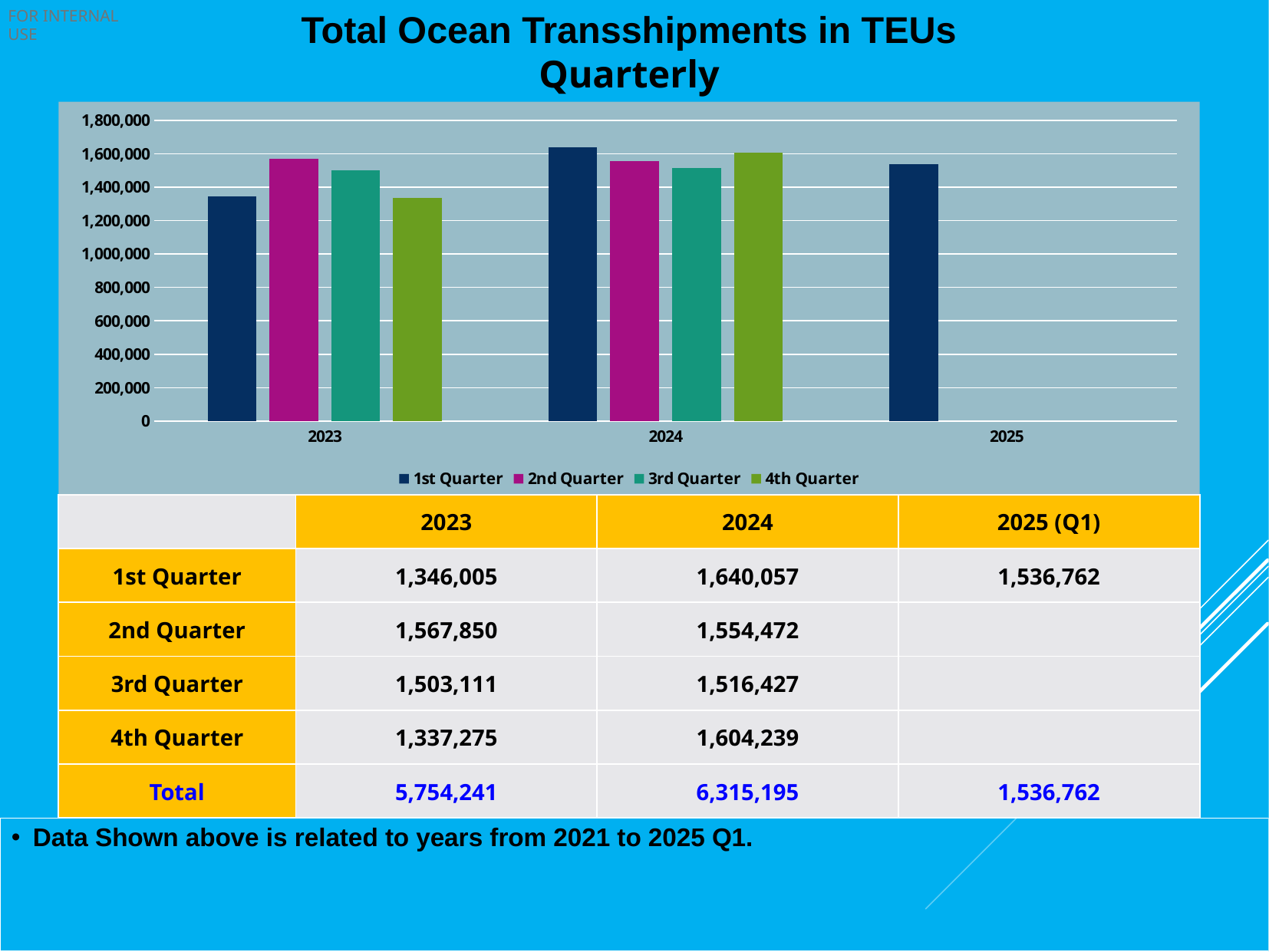
Which year and quarter has the lowest value in the chart? 2023, 4th Quarter Which is larger in 2023, the 2nd Quarter or the 3rd Quarter? 2nd Quarter What kind of chart is shown on the slide? bar chart Does the 1st Quarter value rise or fall from 2023 to 2024? rise How many year categories are shown on the x axis of the chart? 3 What is the value for the 1st Quarter in 2024? 1,640,057 What is the value for the 4th Quarter in 2023? 1,337,275 Which year and quarter has the highest value in the chart? 2024, 1st Quarter Is the value for the 1st Quarter in 2023 greater or less than 1,400,000? less How many series does the chart legend list? 4 What is the difference between the 1st Quarter values for 2024 and 2023? 294,052 What is the value for the 1st Quarter in 2025? 1,536,762